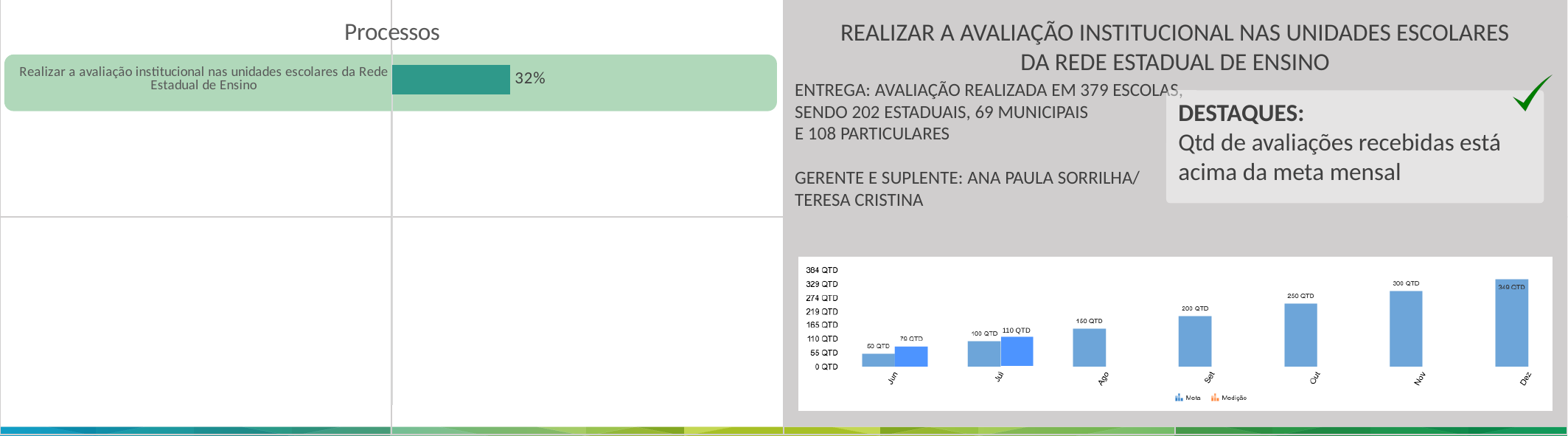
In the monthly chart at the bottom right, how many series does the legend list? 2 In the monthly chart at the bottom right, what is the Meta value for Out? 250 QTD What kind of chart is the 'Processos' chart on the left of the slide? bar chart In the 'Processos' chart on the left, what value is shown for 'Realizar a avaliação institucional nas unidades escolares da Rede Estadual de Ensino'? 32% In the monthly chart at the bottom right, do the Meta values rise or fall from Jun to Dez? rise In the monthly chart at the bottom right, which month has the lowest Meta value? Jun In the monthly chart at the bottom right, what is the Meta value for Set? 200 QTD In the 'Processos' chart on the left, how many bars are plotted? 1 In the monthly chart at the bottom right, how many months are shown on the x axis? 7 In the monthly chart at the bottom right, what is the Medição value for Jul? 110 QTD In the monthly chart at the bottom right, which is larger for Jul: Meta or Medição? Medição In the monthly chart at the bottom right, what is the difference between the Meta values for Nov and Ago? 150 QTD